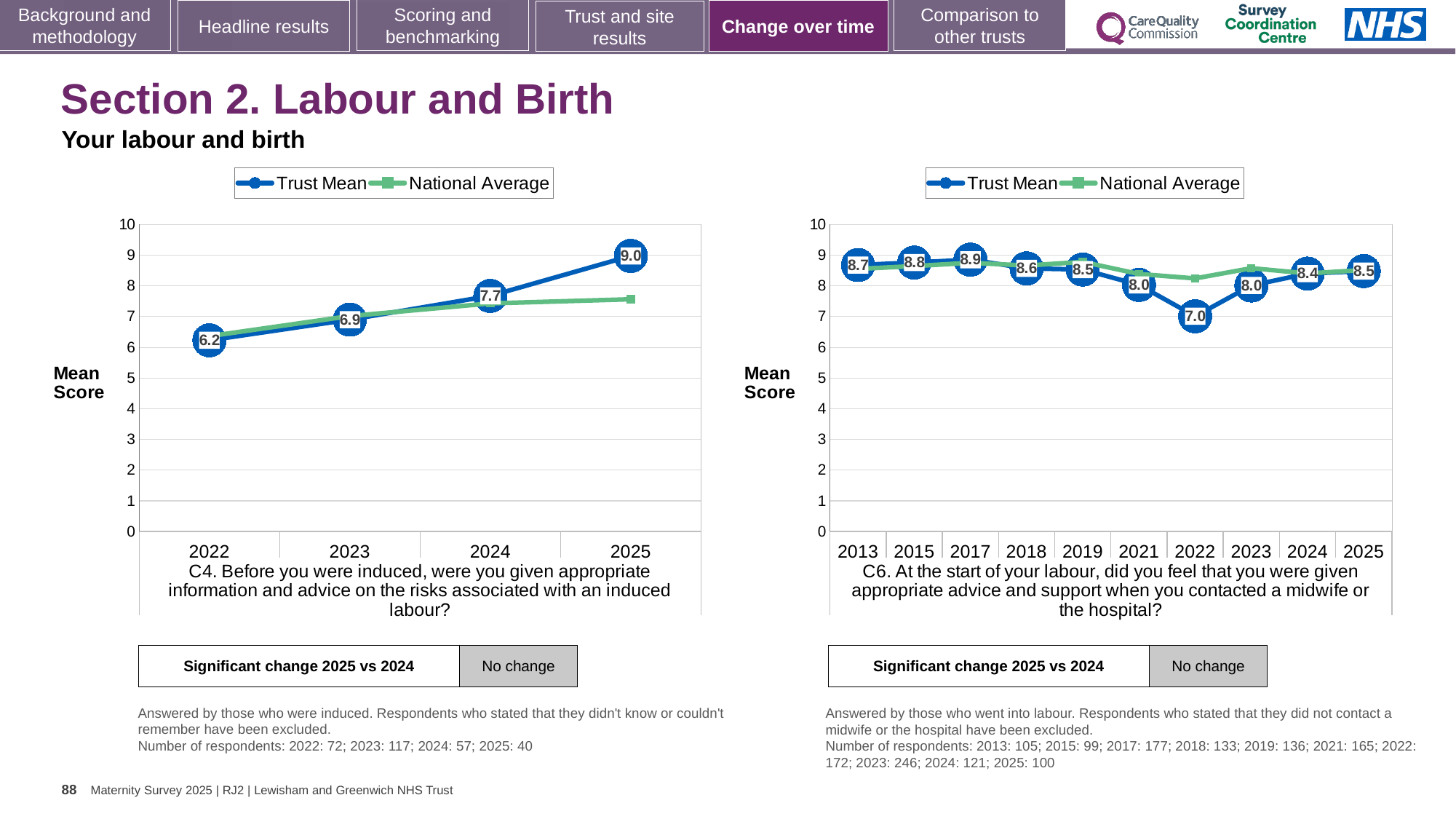
In the right chart (C6), is the Trust Mean score for 2021 higher or lower than for 2024? lower In the left chart (C4), which year has the lowest Trust Mean score? 2022 In the right chart (C6), how many years are shown on the x axis? 10 In the left chart (C4), how many years are shown on the x axis? 4 In the right chart (C6), which year has the lowest Trust Mean score? 2022 In the left chart (C4), does the Trust Mean rise or fall from 2022 to 2025? rise In the left chart (C4), what is the Trust Mean score for 2022? 6.2 In the right chart (C6), which year has the highest Trust Mean score? 2017 In the left chart (C4), what is the difference between the Trust Mean scores for 2025 and 2024? 1.3 In the right chart (C6), what is the Trust Mean score for 2022? 7.0 How many series does the legend of the right chart (C6) list? 2 In the left chart (C4), what is the Trust Mean score for 2025? 9.0